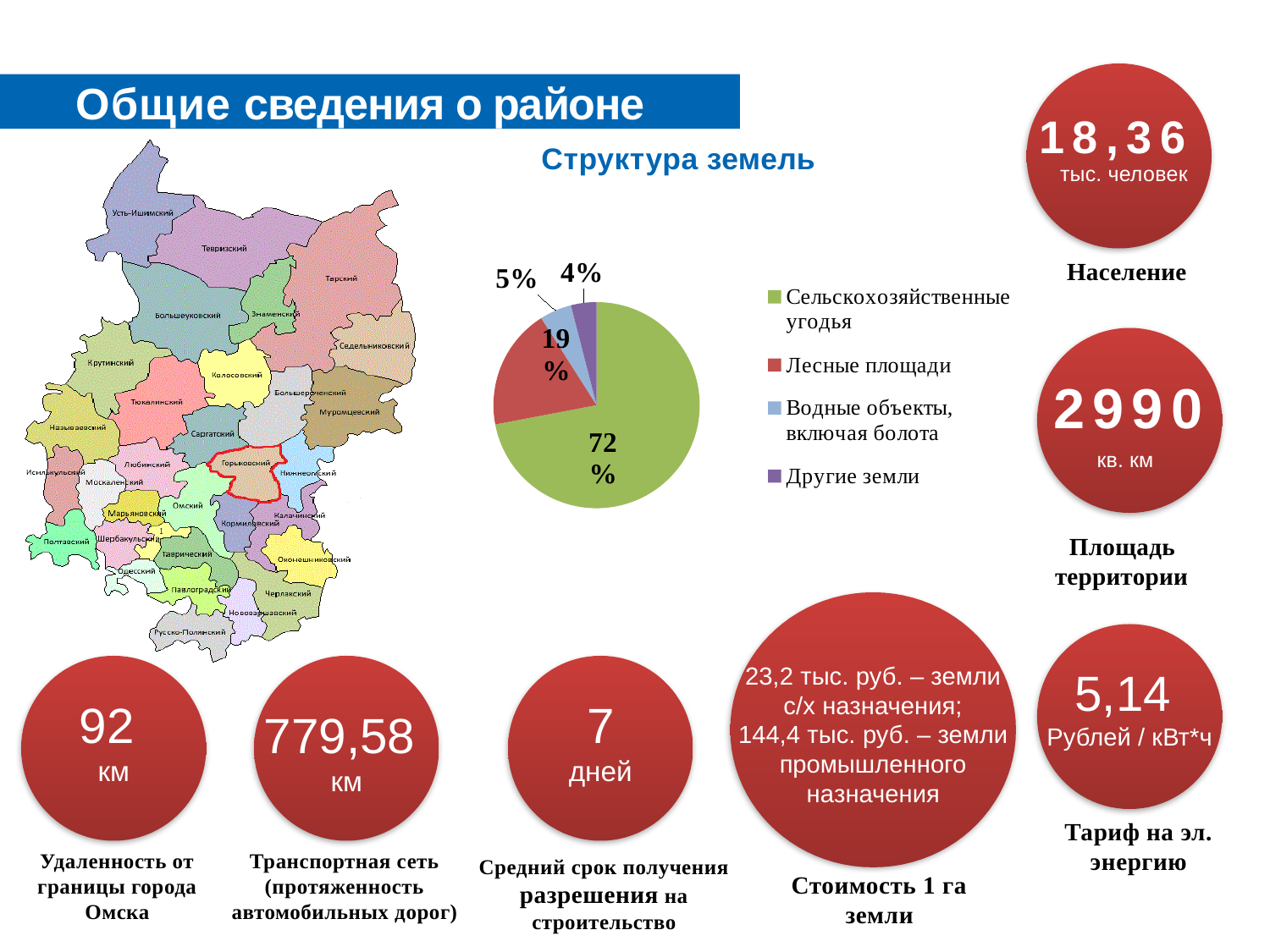
What colour is the 'Лесные площади' slice in the pie chart 'Структура земель'? Red What type of chart is used for 'Структура земель'? Pie chart What share of the pie chart 'Структура земель' is 'Водные объекты, включая болота'? 5% What share of the pie chart 'Структура земель' is 'Лесные площади'? 19% What is the title of the chart on the slide? Структура земель In the pie chart 'Структура земель', which is larger: 'Лесные площади' or 'Водные объекты, включая болота'? Лесные площади What share of the pie chart 'Структура земель' is 'Другие земли'? 4% How many categories does the pie chart 'Структура земель' show? 4 Which category has the smallest slice in the pie chart 'Структура земель'? Другие земли In the pie chart 'Структура земель', what is the difference in percentage points between 'Сельскохозяйственные угодья' and 'Лесные площади'? 53 What share of the pie chart 'Структура земель' is 'Сельскохозяйственные угодья'? 72% Which category has the largest slice in the pie chart 'Структура земель'? Сельскохозяйственные угодья